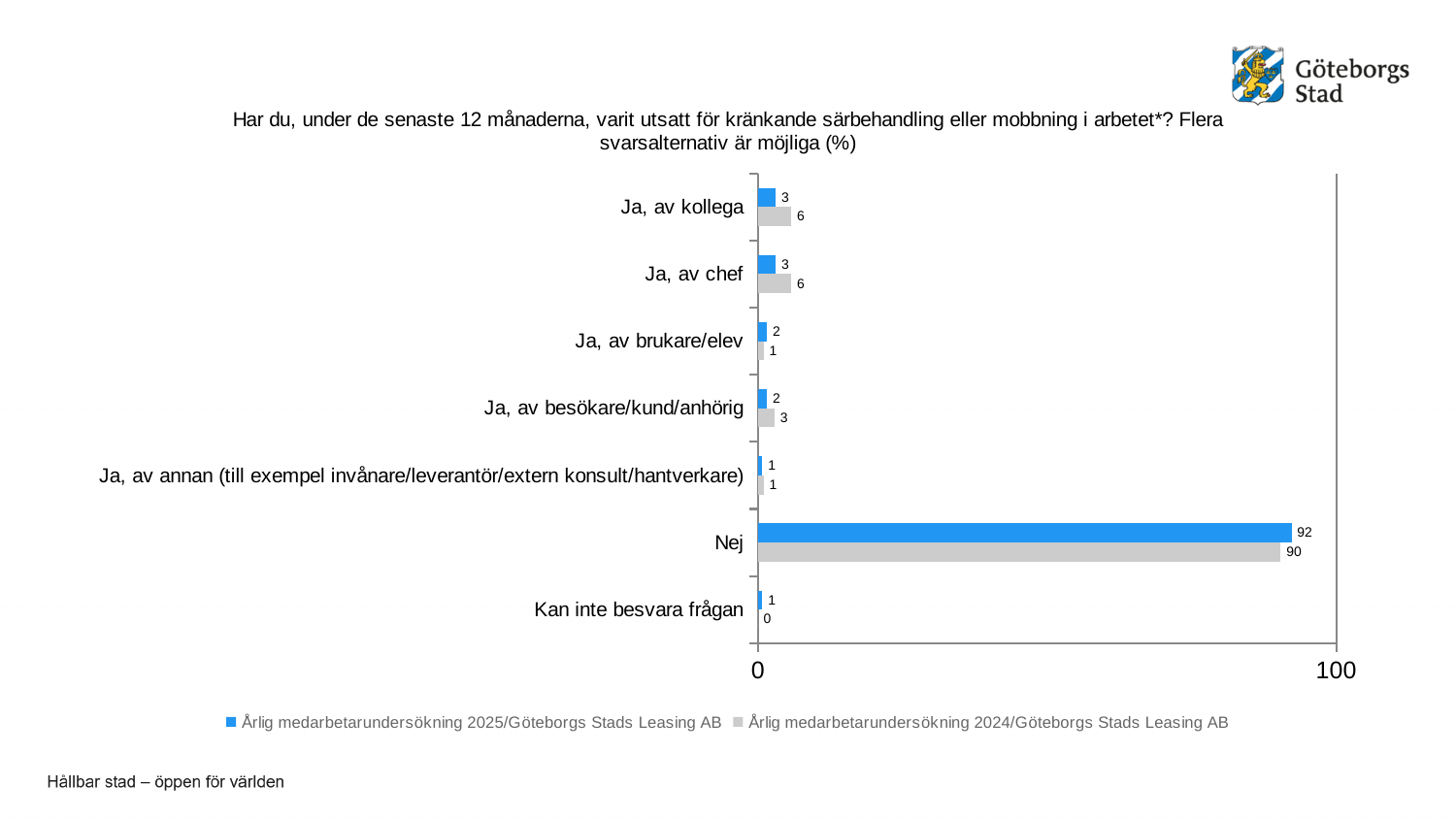
What kind of chart is shown on the slide? Bar chart For "Ja, av besökare/kund/anhörig", which series has the larger value, 2025 or 2024? 2024 Which colour represents the 2025 series (Årlig medarbetarundersökning 2025/Göteborgs Stads Leasing AB)? Blue What is the value for "Kan inte besvara frågan" in the 2024 series? 0 How many categories are shown on the chart? 7 What is the difference between the 2025 and 2024 values for "Nej"? 2 How many series does the legend list? 2 Which category has the highest value in the 2025 series? Nej What is the value for "Ja, av kollega" in the 2024 series (Årlig medarbetarundersökning 2024/Göteborgs Stads Leasing AB)? 6 What is the value for "Nej" in the 2025 series (Årlig medarbetarundersökning 2025/Göteborgs Stads Leasing AB)? 92 What is the difference between the 2025 and 2024 values for "Ja, av chef"? 3 For "Ja, av brukare/elev", which series has the larger value, 2025 or 2024? 2025